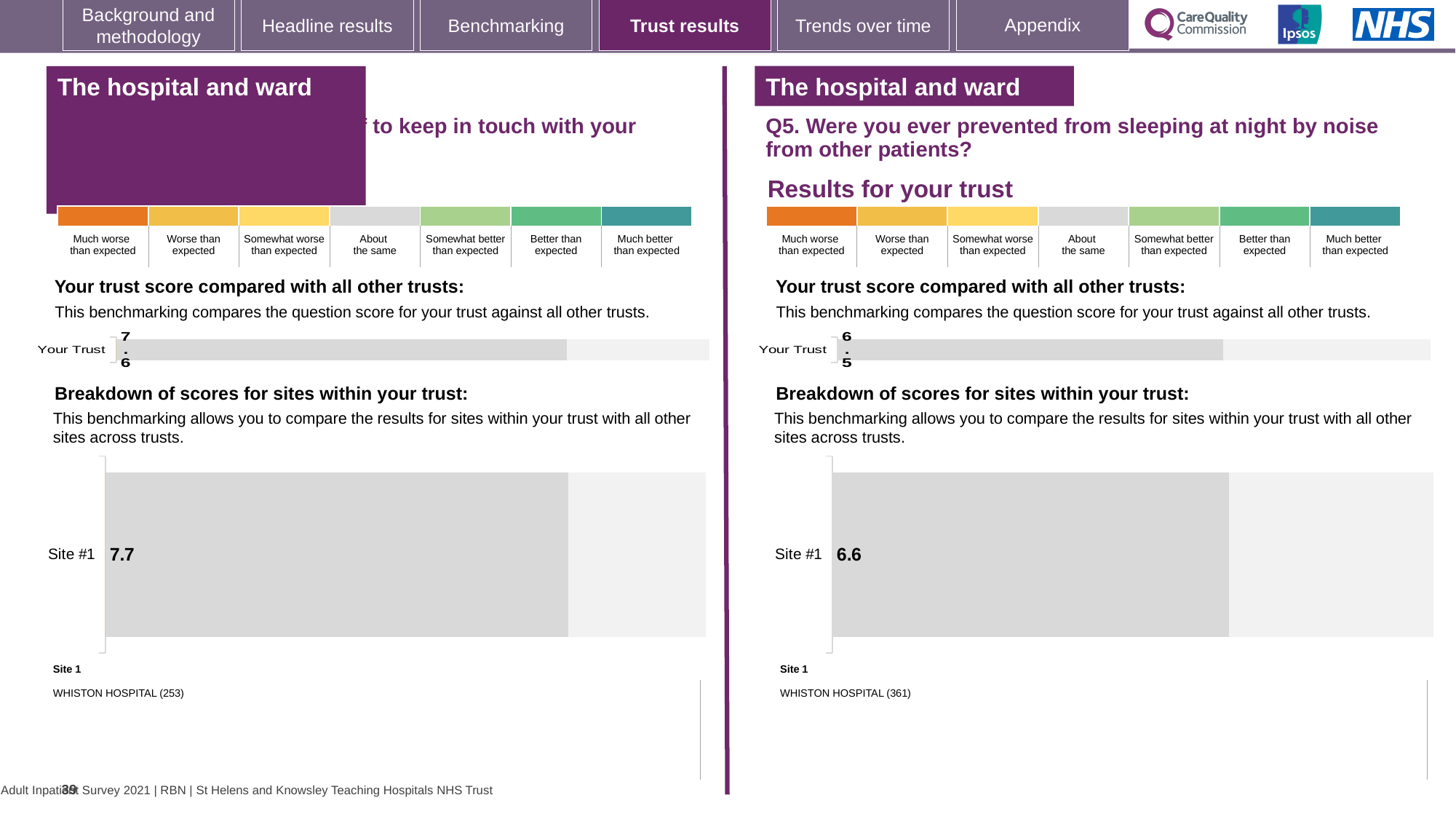
On the right-hand side of the slide (Q5), what is the difference between the Site #1 score and the trust score? 0.1 On the left-hand side of the slide, which hospital is listed as Site 1 and how many respondents are shown in brackets? WHISTON HOSPITAL (253) Which is larger: the Site #1 score on the left-hand side of the slide or the Site #1 score on the right-hand side (Q5)? Left-hand side (7.7) How many sites are shown in the breakdown of scores chart on the right-hand side of the slide (Q5)? 1 On the left-hand side of the slide, what is the trust score shown in the 'Your trust score compared with all other trusts' chart? 7.6 On the right-hand side of the slide (Q5, noise from other patients), what is the trust score shown in the 'Your trust score compared with all other trusts' chart? 6.5 On the left-hand side of the slide, what is the difference between the Site #1 score and the trust score? 0.1 On the left-hand side of the slide, what score is shown for Site #1 in the breakdown of scores for sites within your trust? 7.7 On the right-hand side of the slide (Q5), what score is shown for Site #1 in the breakdown of scores for sites within your trust? 6.6 On the right-hand side of the slide (Q5), which hospital is listed as Site 1 and how many respondents are shown in brackets? WHISTON HOSPITAL (361) What kind of chart is used to show the Site #1 score on the right-hand side of the slide (Q5)? Bar chart Which is larger: the trust score on the left-hand side of the slide or the trust score on the right-hand side (Q5)? Left-hand side (7.6)